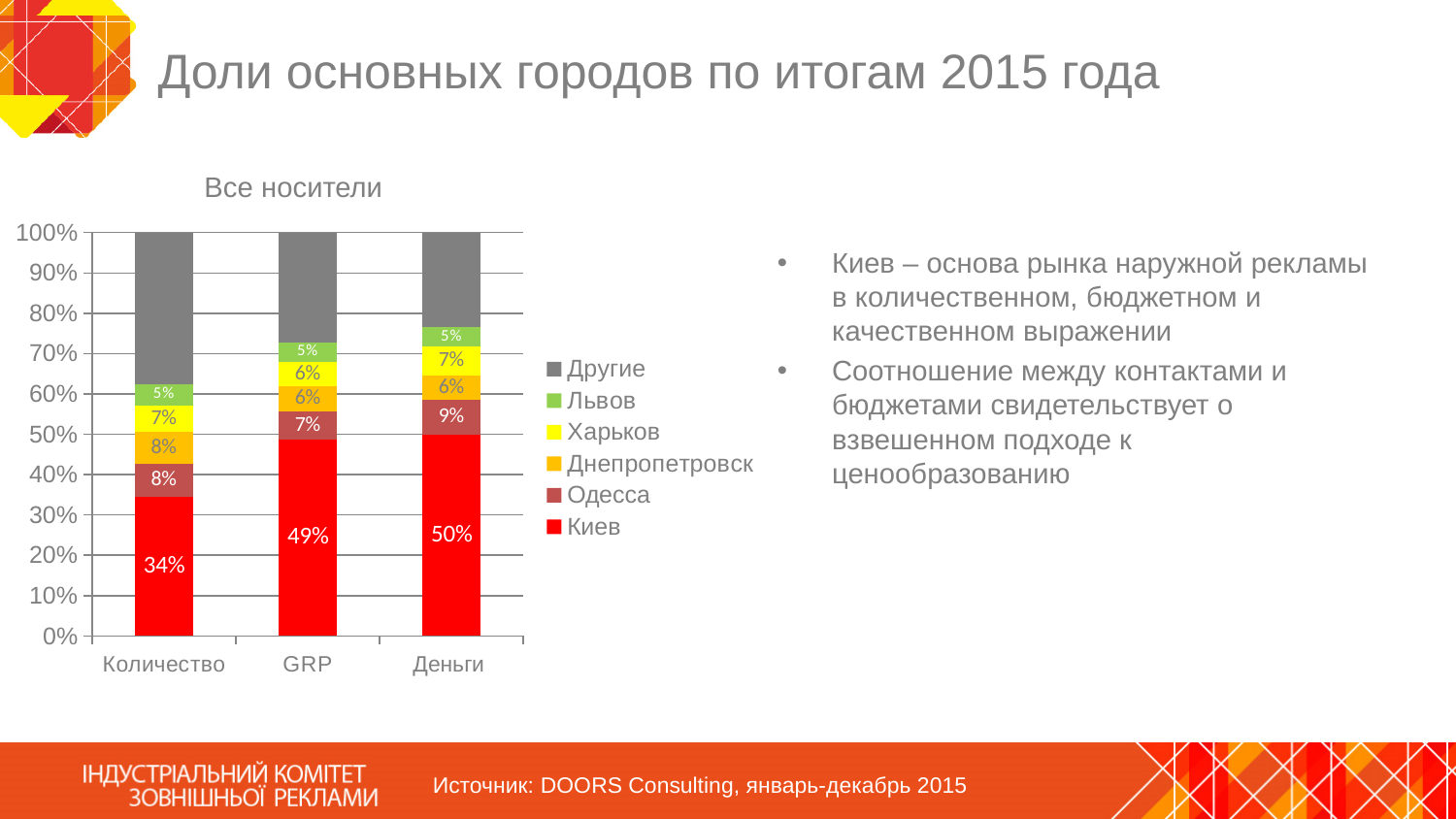
Is the Другие share in the Количество bar greater or less than 30%? greater In which category is the share of Киев the lowest? Количество What is the difference between the Киев share in GRP and in Количество? 15 percentage points What is the value for Киев in the Деньги bar? 50% What is the value for Харьков in the GRP bar? 6% What is the value for Одесса in the Деньги bar? 9% How many categories are shown on the x axis? 3 What is the title of the chart? Все носители How many series does the legend list? 6 What is the value for Киев in the Количество bar? 34% What kind of chart is shown on the slide? Stacked bar chart Which is larger: the Одесса share in Количество or in Деньги? Деньги